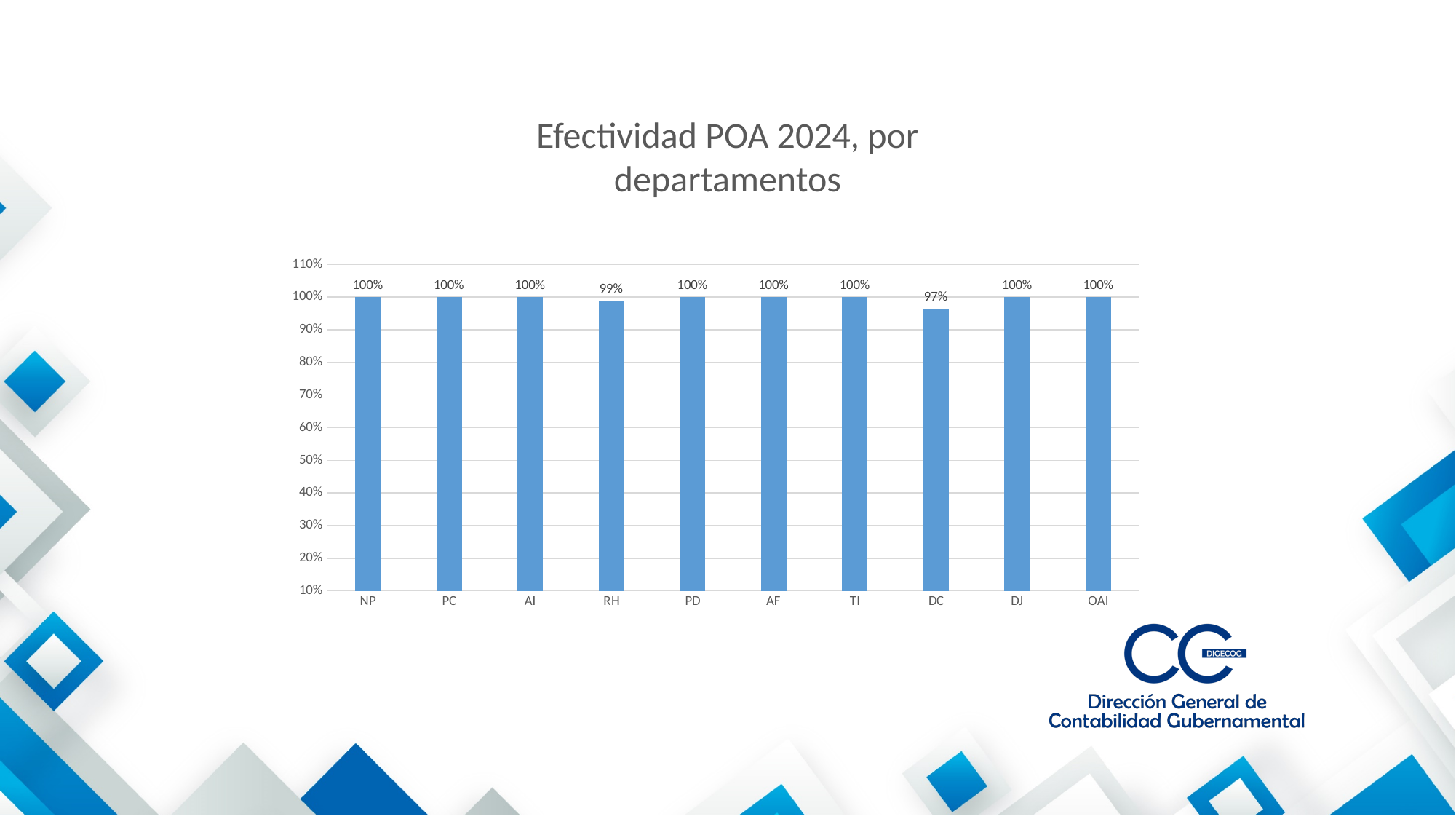
What is the value for DC? 97% What is the difference between the values for RH and DC? 2% What is the value for NP? 100% What is the title of the chart? Efectividad POA 2024, por departamentos Which department has the lowest value? DC How many departments are shown on the x axis? 10 What kind of chart is this? bar chart What is the difference between the values for NP and DC? 3% How many departments have a value of 100%? 8 Is the value for DC greater or less than 90%? greater Which is larger, the value for RH or the value for DC? RH What is the value for RH? 99%